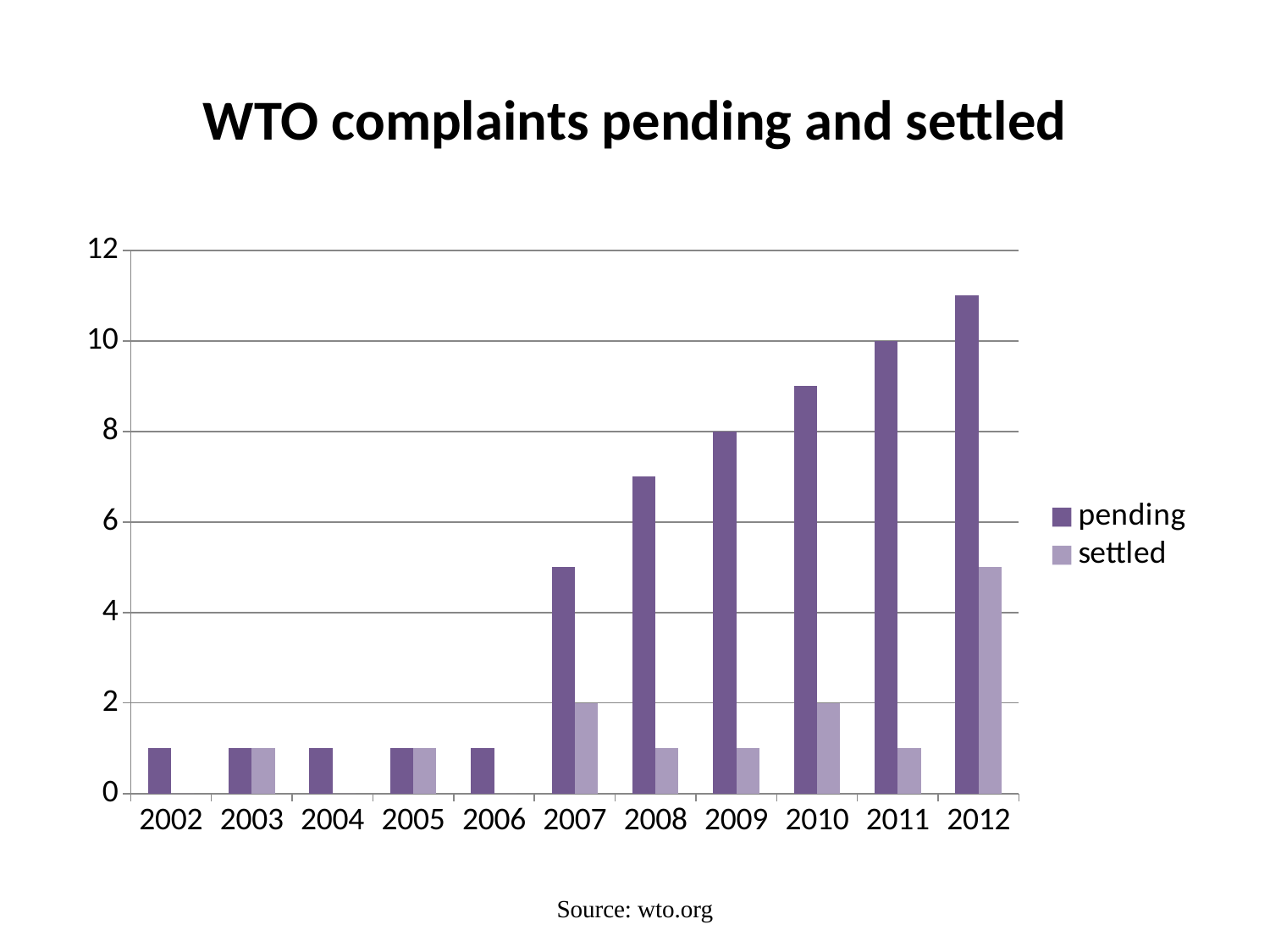
Is the value for settled complaints in 2012 greater or less than 4? greater Which is larger in 2008, pending or settled complaints? pending Is the value for pending complaints in 2012 greater or less than 10? greater What is the value of settled complaints in 2010? 2 How many series does the legend list? 2 Which year has the highest value for pending complaints? 2012 What kind of chart is shown on the slide? bar chart Do pending complaints rise or fall from 2007 to 2012? rise How many years are shown on the x axis? 11 What is the value of pending complaints in 2011? 10 What is the value of settled complaints in 2007? 2 What is the value of pending complaints in 2009? 8